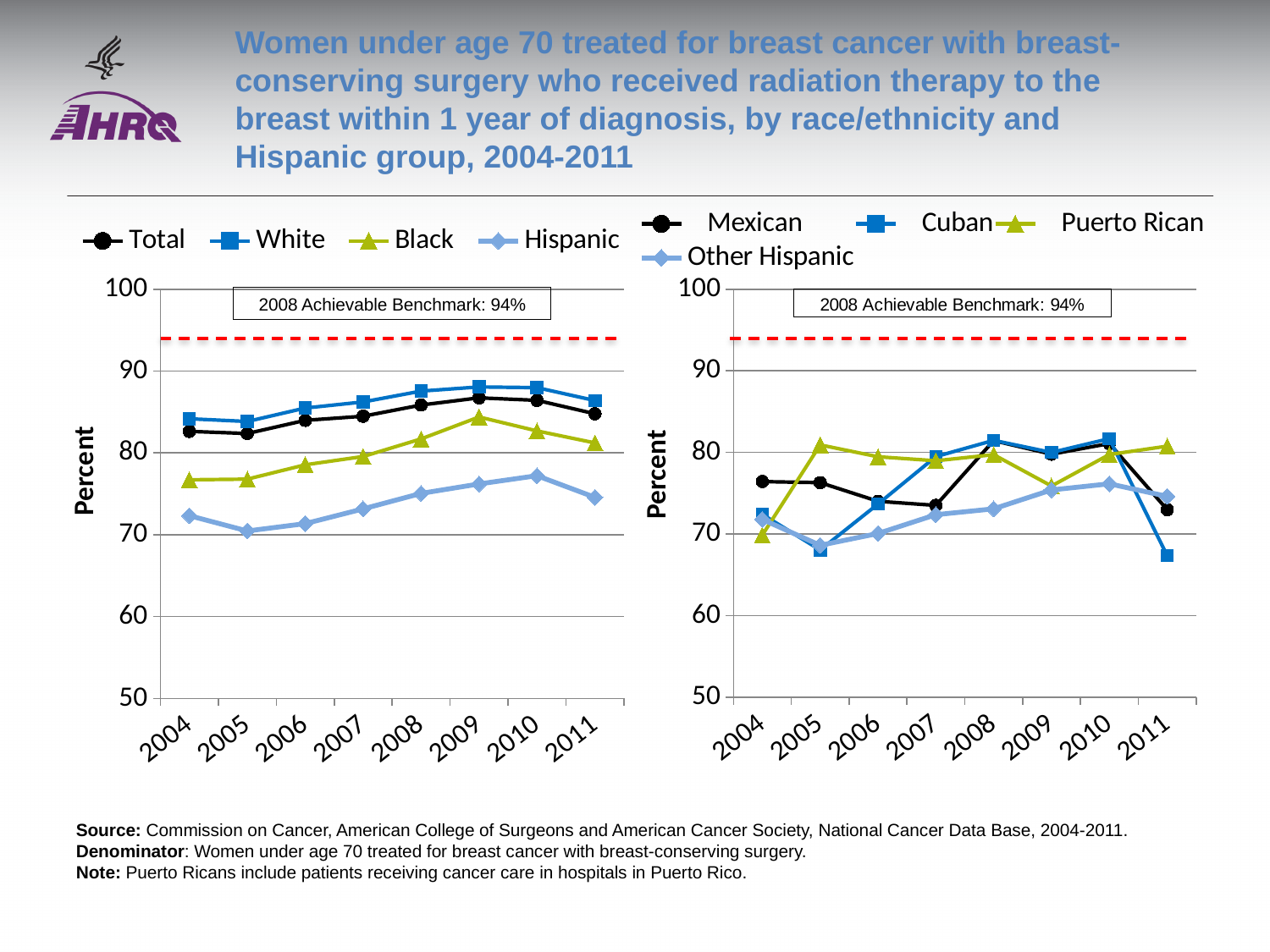
In the left chart, is the value for White in 2009 greater or less than 90? less In the right chart, is the value for Cuban in 2011 greater or less than 70? less What is the 2008 Achievable Benchmark shown on both charts? 94% In the left chart, which series has the highest value in 2009? White In the right chart, which is larger in 2005, Puerto Rican or Cuban? Puerto Rican What kind of chart is the left chart (Total, White, Black, Hispanic)? line chart In the right chart, which series has the lowest value in 2011? Cuban In the left chart, which series has the lowest value in 2011? Hispanic In the left chart, is the value for Black in 2009 greater or less than 80? greater How many years are shown on the x axis of the left chart? 8 How many series does the legend of the right chart (Mexican, Cuban, Puerto Rican, Other Hispanic) list? 4